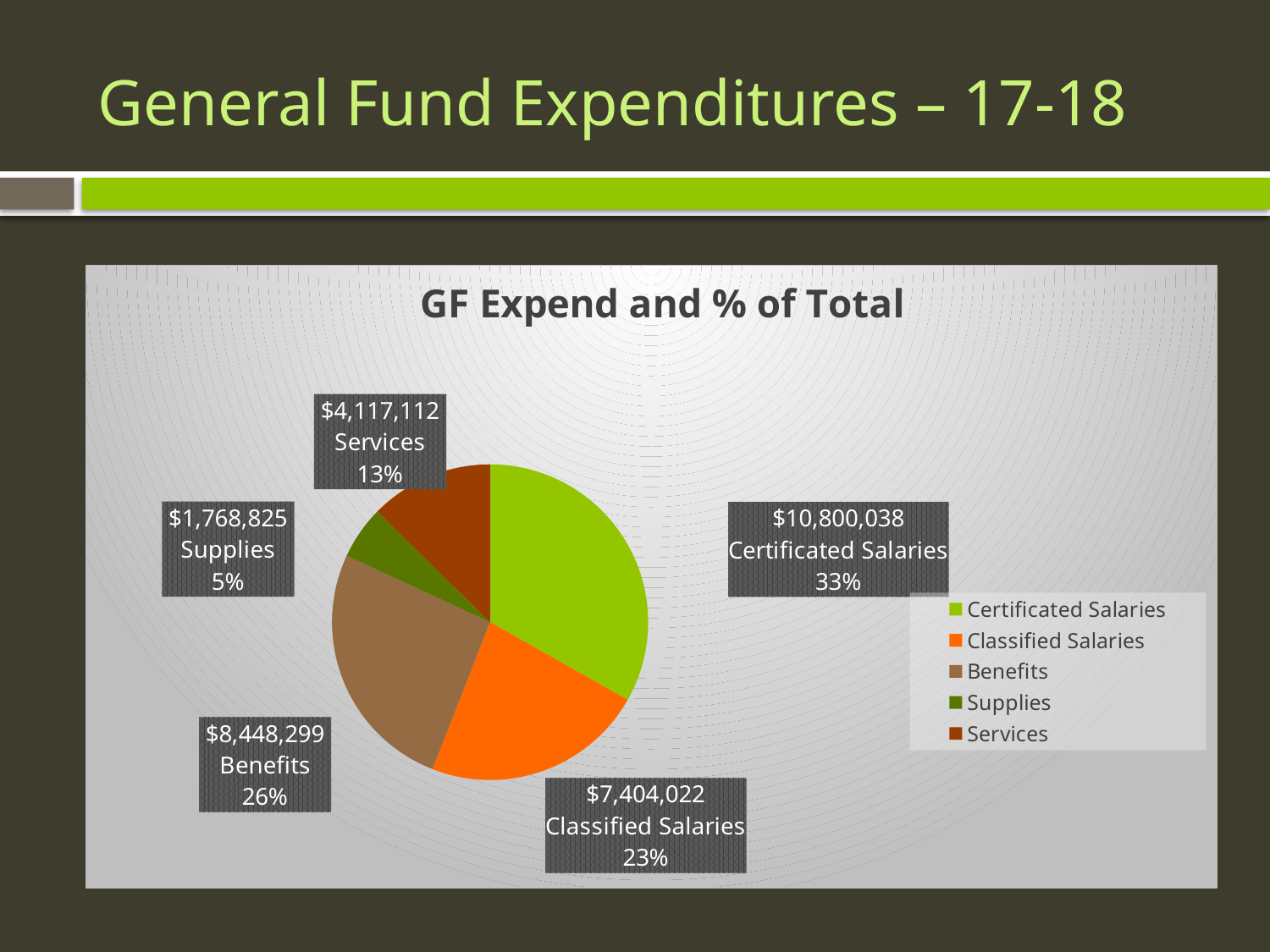
Which is larger, Benefits or Services? Benefits What percentage of the total is Services? 13% Which category has the smallest share of the pie? Supplies What is the value for Supplies? $1,768,825 What percentage of the total is Classified Salaries? 23% What kind of chart is shown on the slide? Pie chart Which category has the largest share of the pie? Certificated Salaries What is the value for Benefits? $8,448,299 What is the difference between the Certificated Salaries value and the Classified Salaries value? $3,396,016 How many categories are shown in the pie chart? 5 What is the title of the chart? GF Expend and % of Total What is the value for Certificated Salaries? $10,800,038